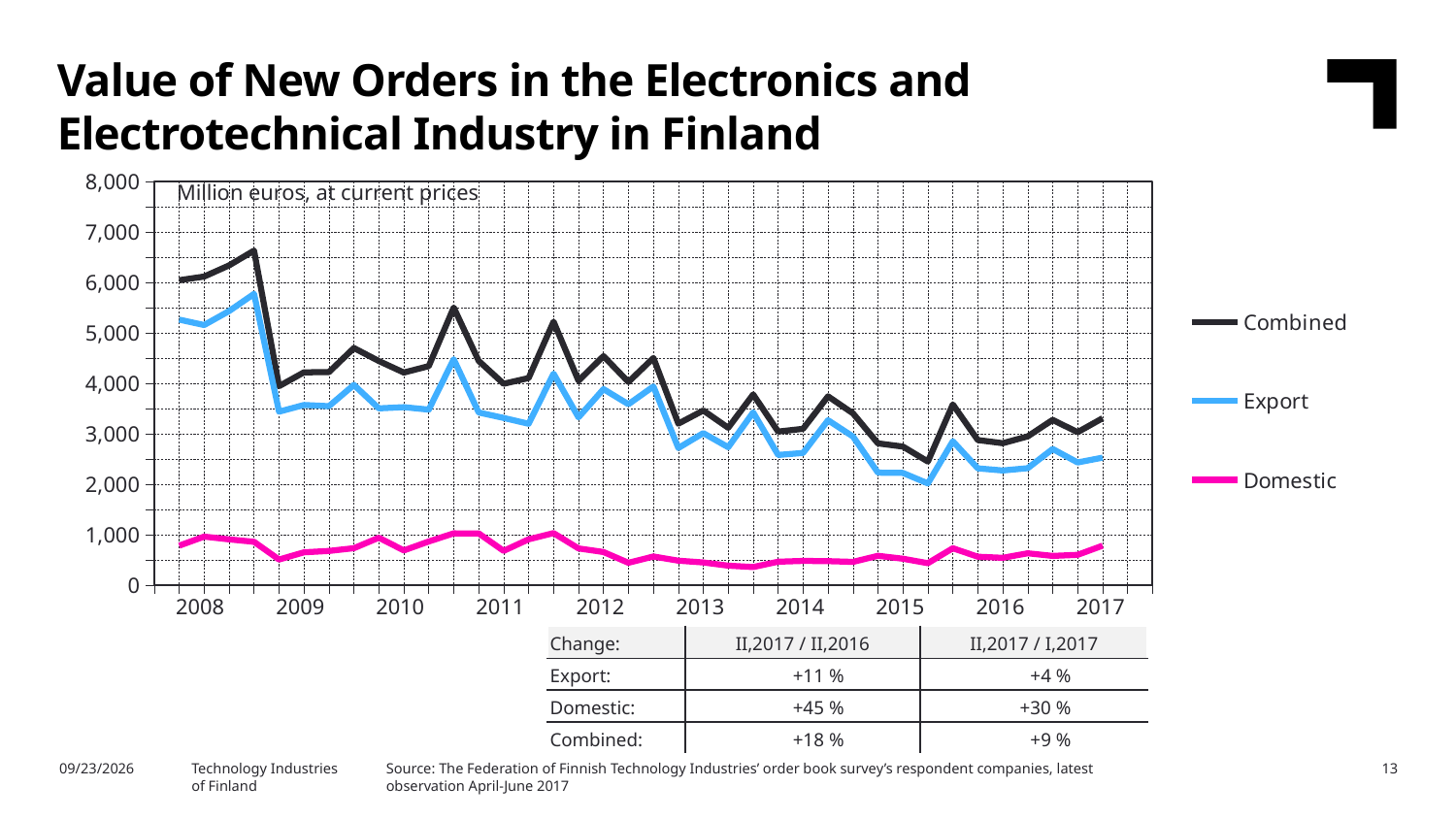
Which series is plotted with the lowest values throughout the chart? Domestic Which series is plotted with the highest values throughout the chart? Combined In what unit are the values on the chart expressed? Million euros, at current prices Is the value for Export at the start of 2008 greater or less than 5,000? greater What kind of chart is shown on the slide? line chart Is the value for Domestic in 2013 greater or less than 1,000? less How many year labels are shown on the x axis? 10 Is the value for Combined at the end of 2017 greater or less than 3,000? greater Overall, do the Combined values rise or fall from 2008 to 2017? fall In 2016, which is larger, the Export value or the Domestic value? Export How many series does the legend list? 3